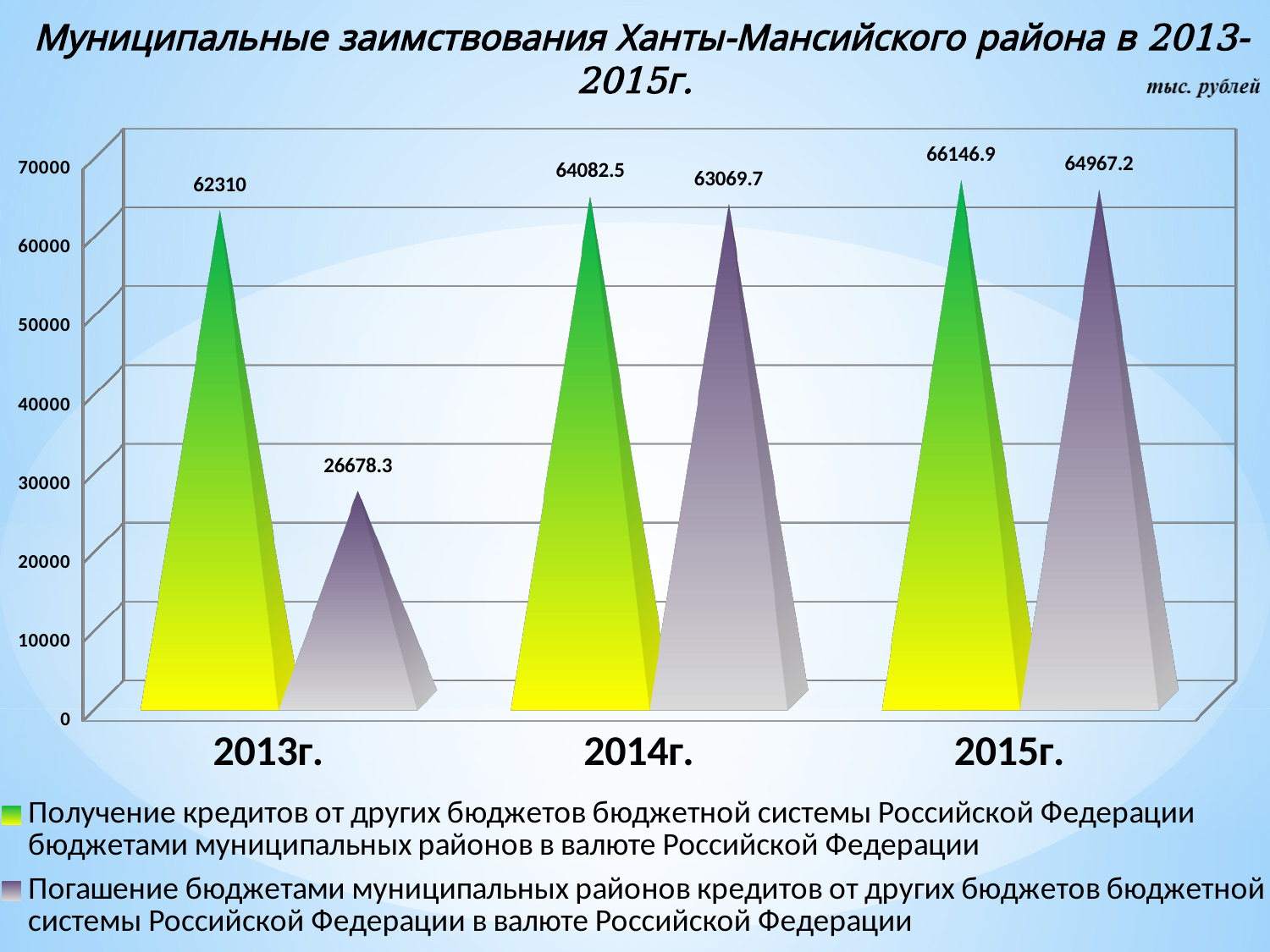
Do the 'Получение кредитов' (green series) values rise or fall from 2013г. to 2015г.? rise In which year is the 'Погашение' (grey series) value lowest? 2013г. How many series does the legend list? 2 How many years (categories) are shown on the x axis? 3 What is the difference between the green and grey series values in 2013г.? 35631.7 What is the value for 'Погашение' (grey series) in 2013г.? 26678.3 What is the value for 'Погашение' (grey series) in 2014г.? 63069.7 What is the value for 'Получение кредитов' (green series) in 2013г.? 62310 What is the difference between the green and grey series values in 2015г.? 1179.7 Which is larger in 2014г.: the 'Получение кредитов' value or the 'Погашение' value? Получение кредитов (64082.5) What is the value for 'Получение кредитов' (green series) in 2015г.? 66146.9 In which year is the 'Получение кредитов' (green series) value highest? 2015г.